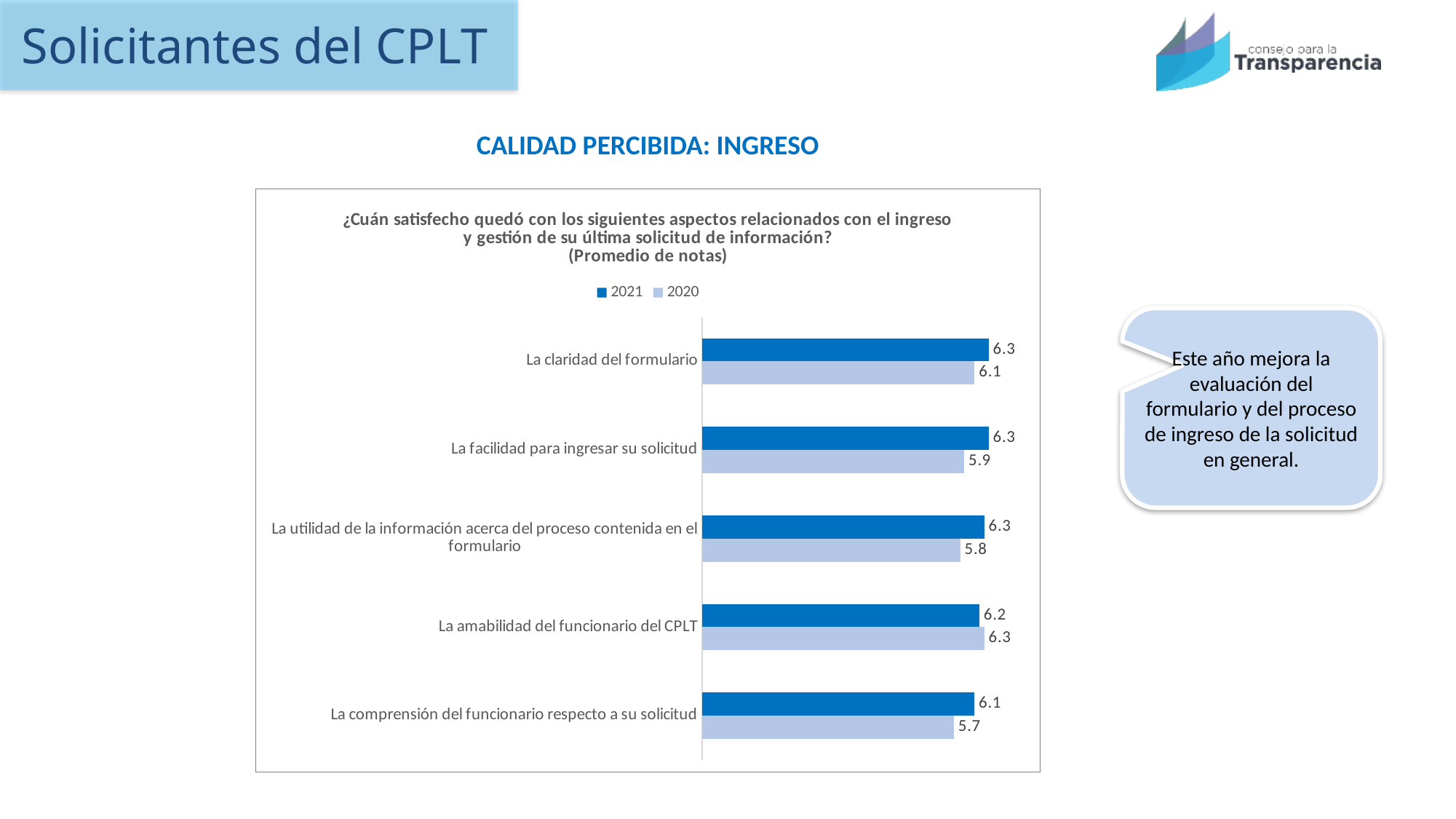
Which series is shown in dark blue in the legend? 2021 Which category has the highest 2020 value? La amabilidad del funcionario del CPLT What is the 2020 value for 'La facilidad para ingresar su solicitud'? 5.9 For 'La amabilidad del funcionario del CPLT', which year has the larger value, 2021 or 2020? 2020 What kind of chart is shown on the slide? Bar chart What is the 2021 value for 'La amabilidad del funcionario del CPLT'? 6.2 What is the difference between the 2021 and 2020 values for 'La utilidad de la información acerca del proceso contenida en el formulario'? 0.5 Which category has the lowest 2020 value? La comprensión del funcionario respecto a su solicitud How many categories are shown in the chart? 5 How many series does the legend list? 2 What is the 2021 value for 'La claridad del formulario'? 6.3 What is the 2020 value for 'La comprensión del funcionario respecto a su solicitud'? 5.7